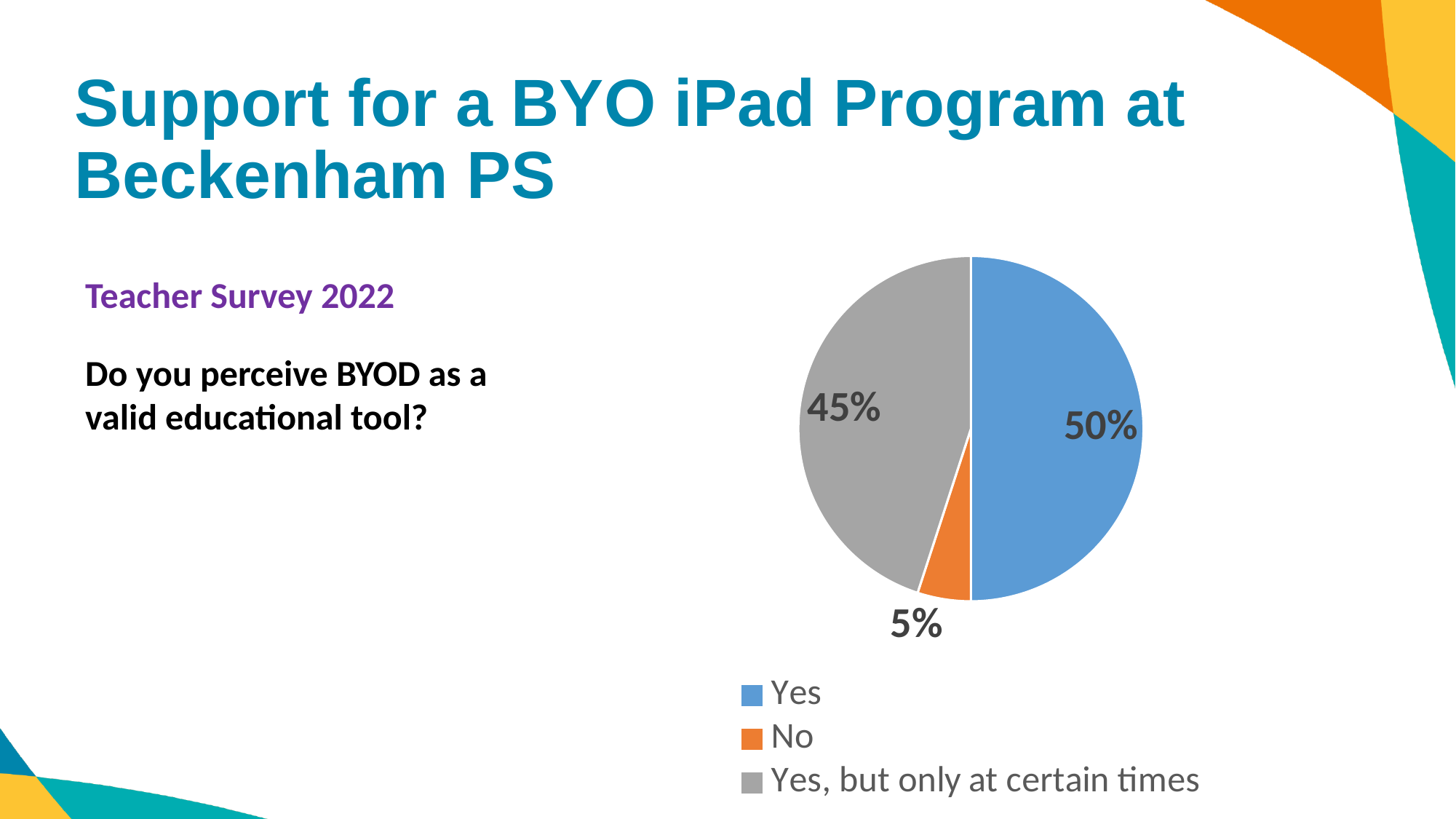
What colour is the slice for "No"? Orange What is the difference in percentage points between "Yes, but only at certain times" and "No"? 40 What survey question does the pie chart answer? Do you perceive BYOD as a valid educational tool? How many slices does the pie chart have? 3 What kind of chart is shown on the slide? Pie chart What percentage of teachers answered "No"? 5% Which is larger: the share for "Yes" or the share for "No"? Yes What percentage of teachers answered "Yes, but only at certain times"? 45% Which response has the largest share of the pie? Yes What percentage of teachers answered "Yes"? 50% What is the difference in percentage points between "Yes" and "Yes, but only at certain times"? 5 Which response has the smallest share of the pie? No